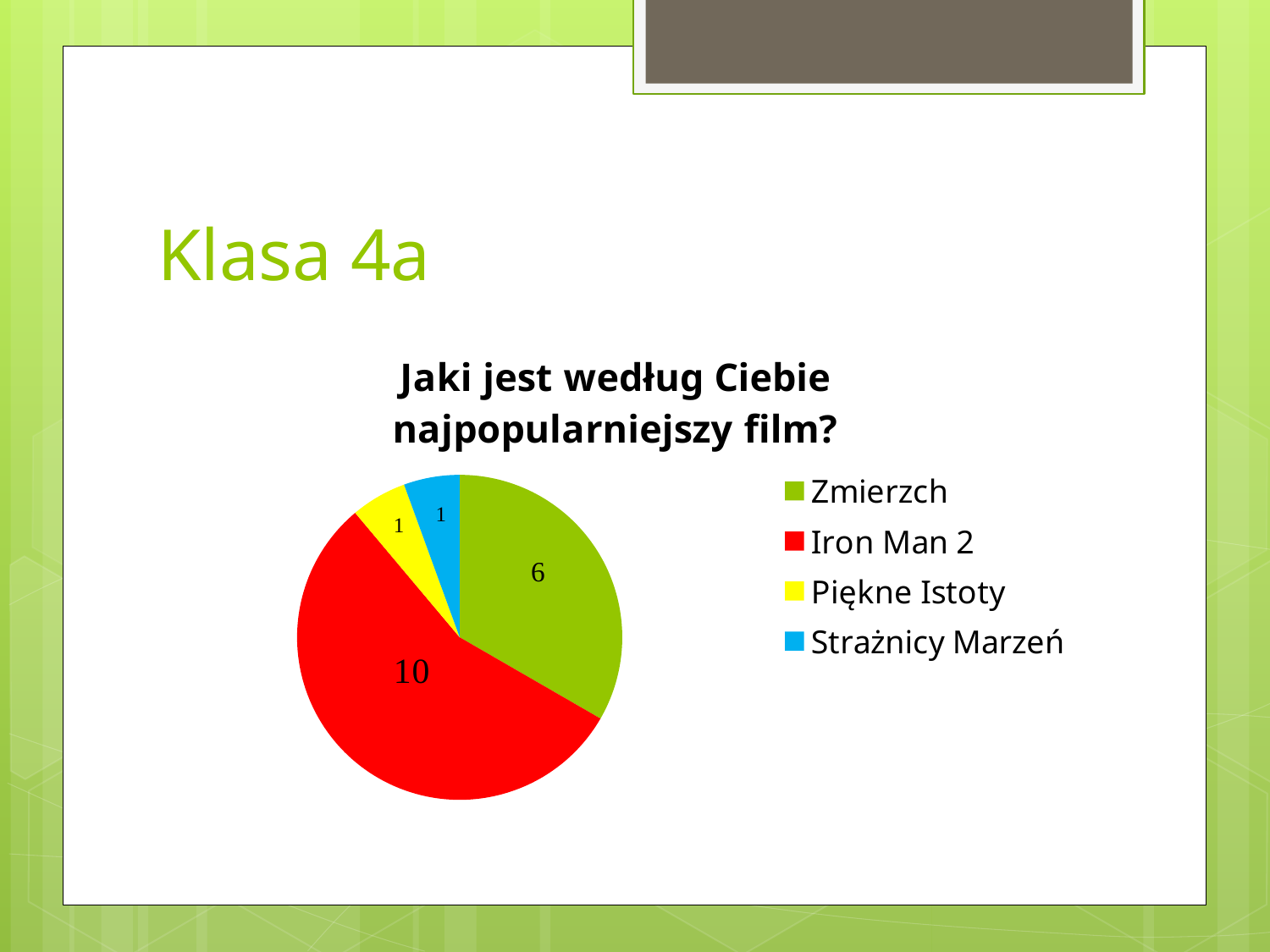
What is the total of all slices in the pie chart? 18 How many entries does the legend list? 4 What is the value for Piękne Istoty? 1 What is the value for Iron Man 2? 10 What is the value for Strażnicy Marzeń? 1 What is the title of the chart? Jaki jest według Ciebie najpopularniejszy film? How many slices does the pie chart have? 4 Which film has the largest slice of the pie? Iron Man 2 What is the value for Zmierzch? 6 What is the difference between the values for Iron Man 2 and Zmierzch? 4 What type of chart is shown on the slide? pie chart Which is larger, the value for Zmierzch or the value for Piękne Istoty? Zmierzch